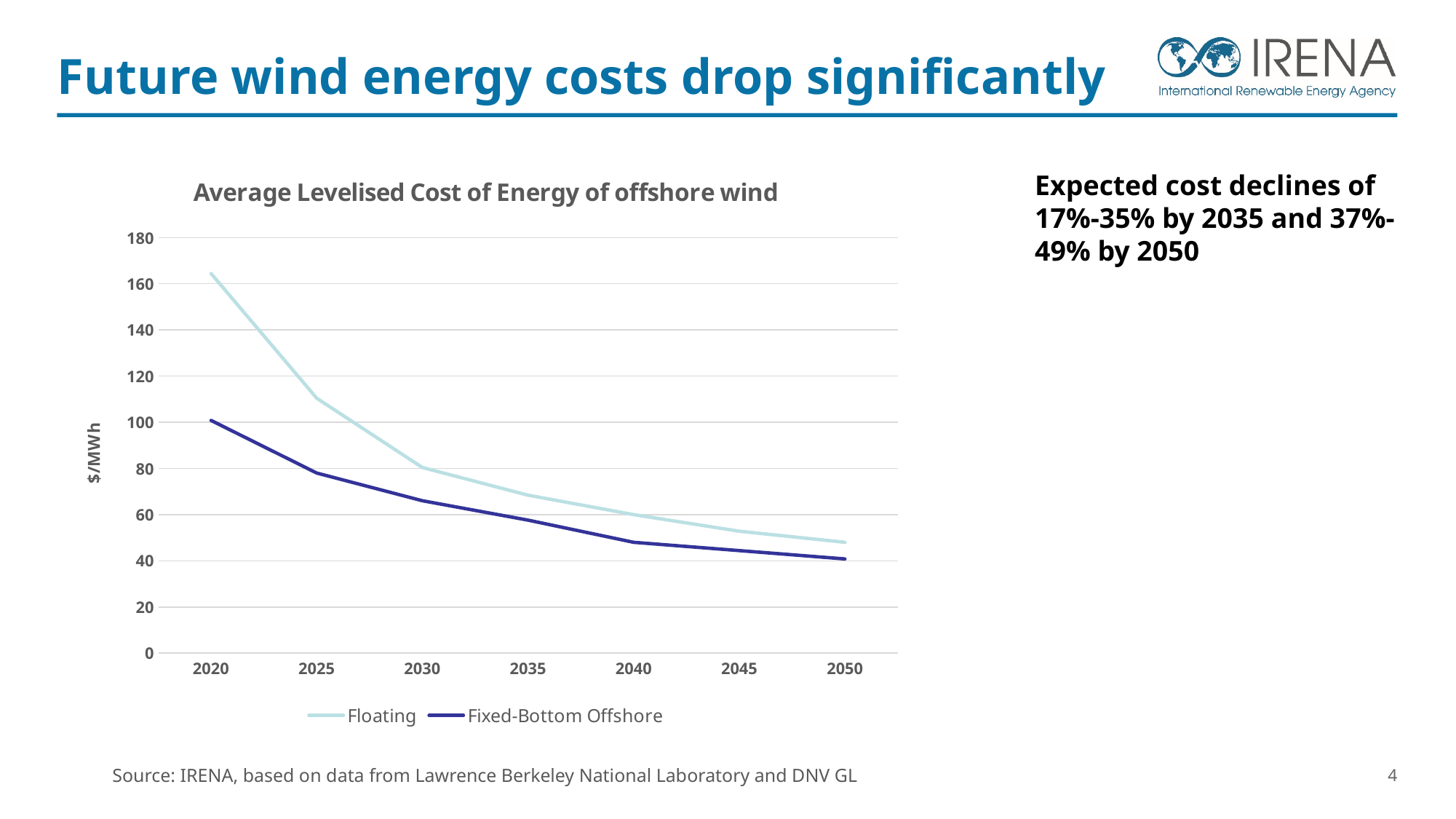
Do the values for the Floating series rise or fall from 2020 to 2050? fall Is the value for Floating in 2020 greater or less than 160? greater Is the value for Floating in 2050 greater or less than 60? less In 2020, which series has the higher value, Floating or Fixed-Bottom Offshore? Floating What kind of chart is shown on the slide? line chart What unit is shown on the y axis of the chart? $/MWh How many series does the chart legend list? 2 Is the value for Fixed-Bottom Offshore in 2020 greater or less than 80? greater In which year is the Floating series at its highest value? 2020 How many years are marked along the x axis of the chart? 7 In which year is the Fixed-Bottom Offshore series at its lowest value? 2050